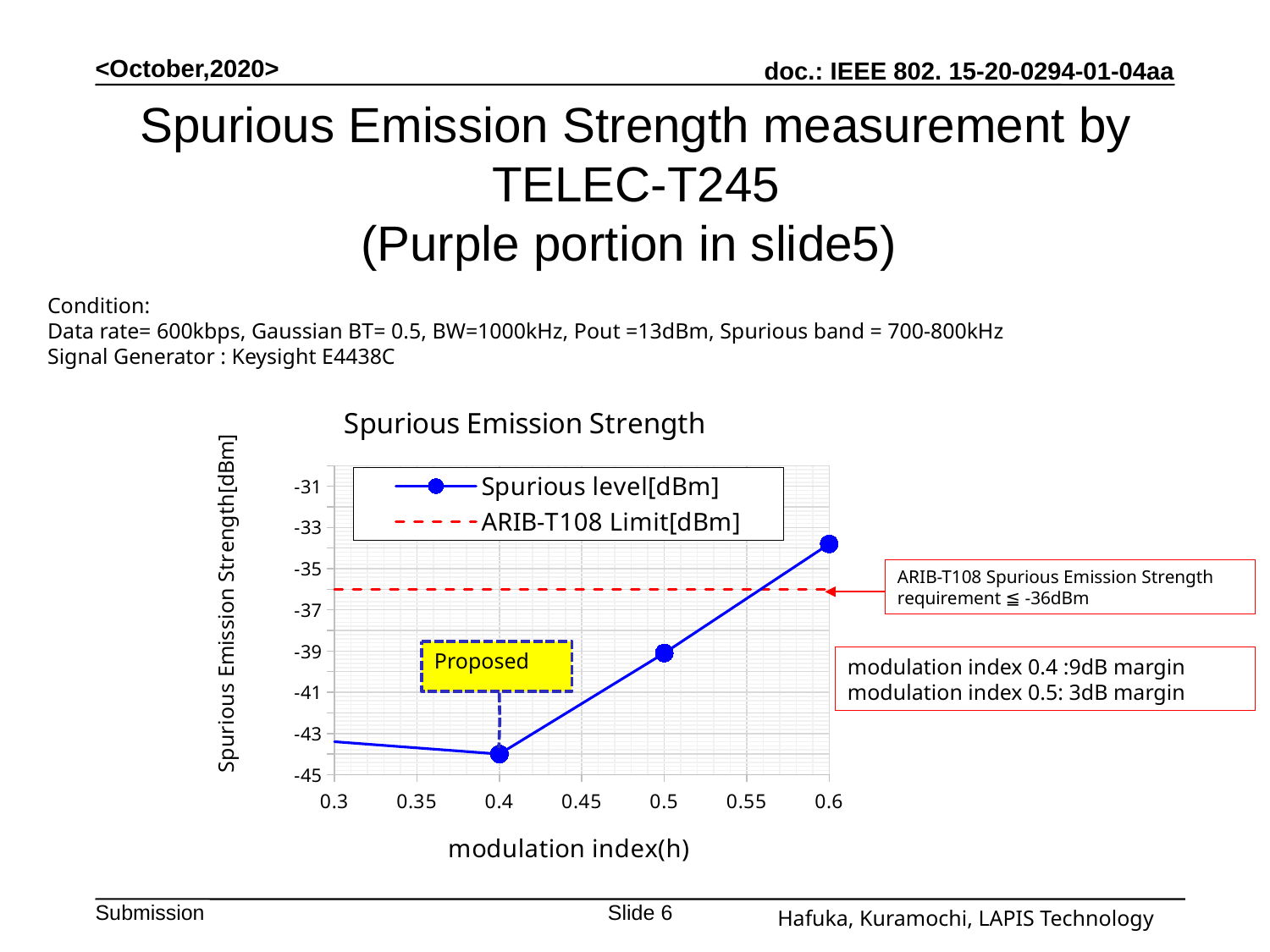
Does the spurious level rise or fall as the modulation index increases from 0.4 to 0.6? rise At which modulation index is the spurious level highest? 0.6 Is the spurious level at modulation index 0.5 greater or less than -37? less At which modulation index is the spurious level lowest? 0.4 Which is larger, the spurious level at modulation index 0.5 or at 0.4? 0.5 What is the ARIB-T108 Spurious Emission Strength requirement shown by the dashed limit line? -36dBm Is the spurious level at modulation index 0.6 greater or less than -35? greater What are the two series named in the chart legend? Spurious level[dBm] and ARIB-T108 Limit[dBm] What is the title of the chart? Spurious Emission Strength What type of chart is shown on the slide? line chart Is the spurious level at modulation index 0.4 greater or less than -43? less How many series does the chart legend list? 2